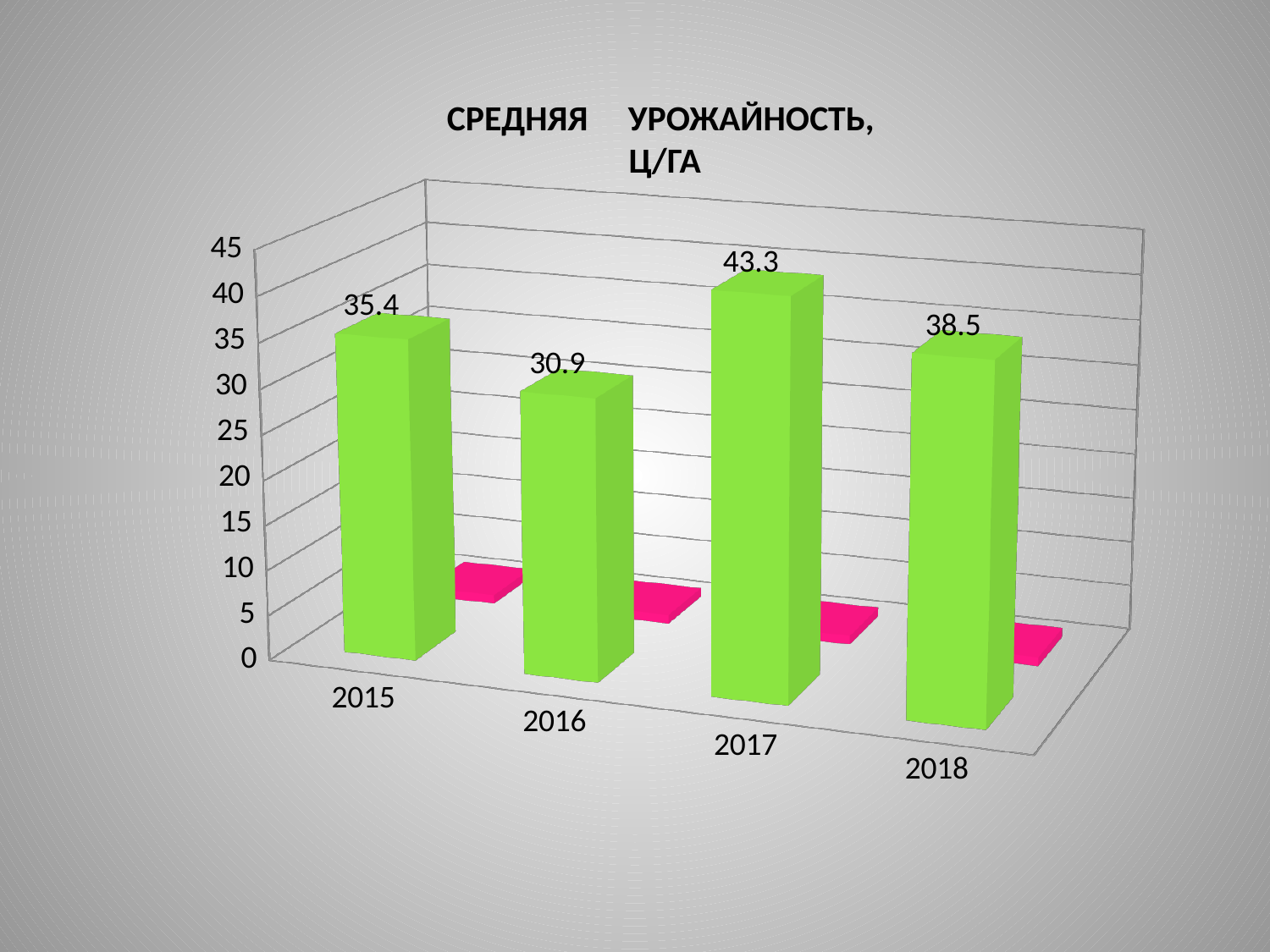
Which year has the highest value? 2017 What is the title of the chart? СРЕДНЯЯ УРОЖАЙНОСТЬ, Ц/ГА What is the value for 2017? 43.3 How many years are shown on the x axis? 4 What kind of chart is shown on the slide? bar chart What is the value for 2016? 30.9 What is the difference between the values for 2017 and 2016? 12.4 Which is larger, the value for 2018 or the value for 2015? 2018 What is the value for 2018? 38.5 Is the value for 2016 greater or less than 35? less What is the value for 2015? 35.4 Which year has the lowest value? 2016